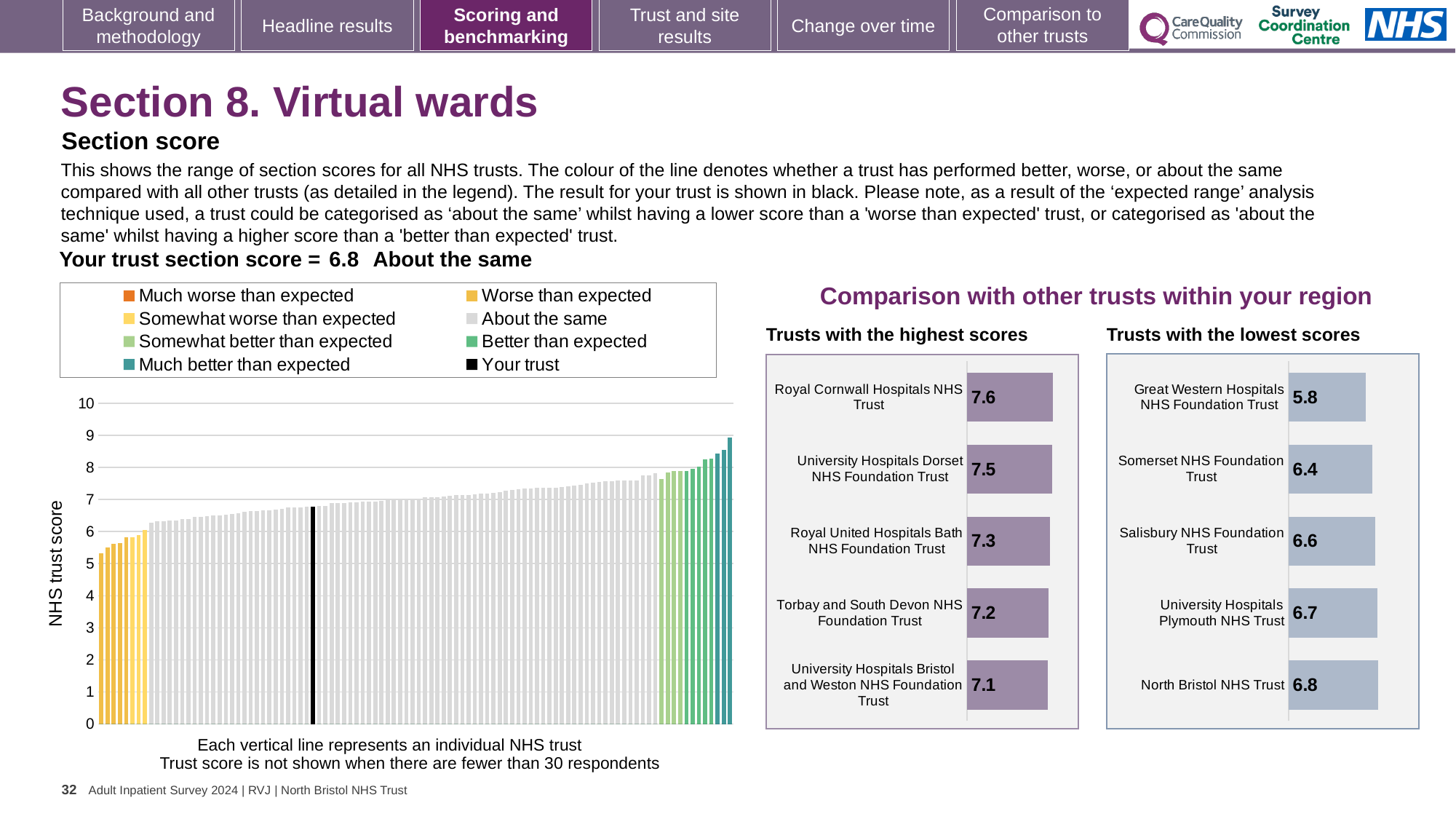
In the 'Trusts with the lowest scores' chart, what is the score for Salisbury NHS Foundation Trust? 6.6 In the 'Trusts with the lowest scores' chart, what is the score for Great Western Hospitals NHS Foundation Trust? 5.8 How many trusts are listed in the 'Trusts with the highest scores' chart? 5 How many entries does the legend of the large 'NHS trust score' chart on the left list? 8 In the 'Trusts with the lowest scores' chart, which trust has the highest score shown? North Bristol NHS Trust In the 'Trusts with the lowest scores' chart, which has the larger score: Somerset NHS Foundation Trust or University Hospitals Plymouth NHS Trust? University Hospitals Plymouth NHS Trust In the 'Trusts with the highest scores' chart, what is the difference between the scores of Royal Cornwall Hospitals NHS Trust and University Hospitals Dorset NHS Foundation Trust? 0.1 In the 'Trusts with the lowest scores' chart, what is the difference between the scores of North Bristol NHS Trust and Great Western Hospitals NHS Foundation Trust? 1.0 In the 'Trusts with the highest scores' chart, what is the score for Royal Cornwall Hospitals NHS Trust? 7.6 In the 'Trusts with the highest scores' chart, which trust has the lowest score shown? University Hospitals Bristol and Weston NHS Foundation Trust In the 'Trusts with the highest scores' chart, what is the score for Torbay and South Devon NHS Foundation Trust? 7.2 In the large 'NHS trust score' chart on the left, do the bars rise or fall from left to right? rise